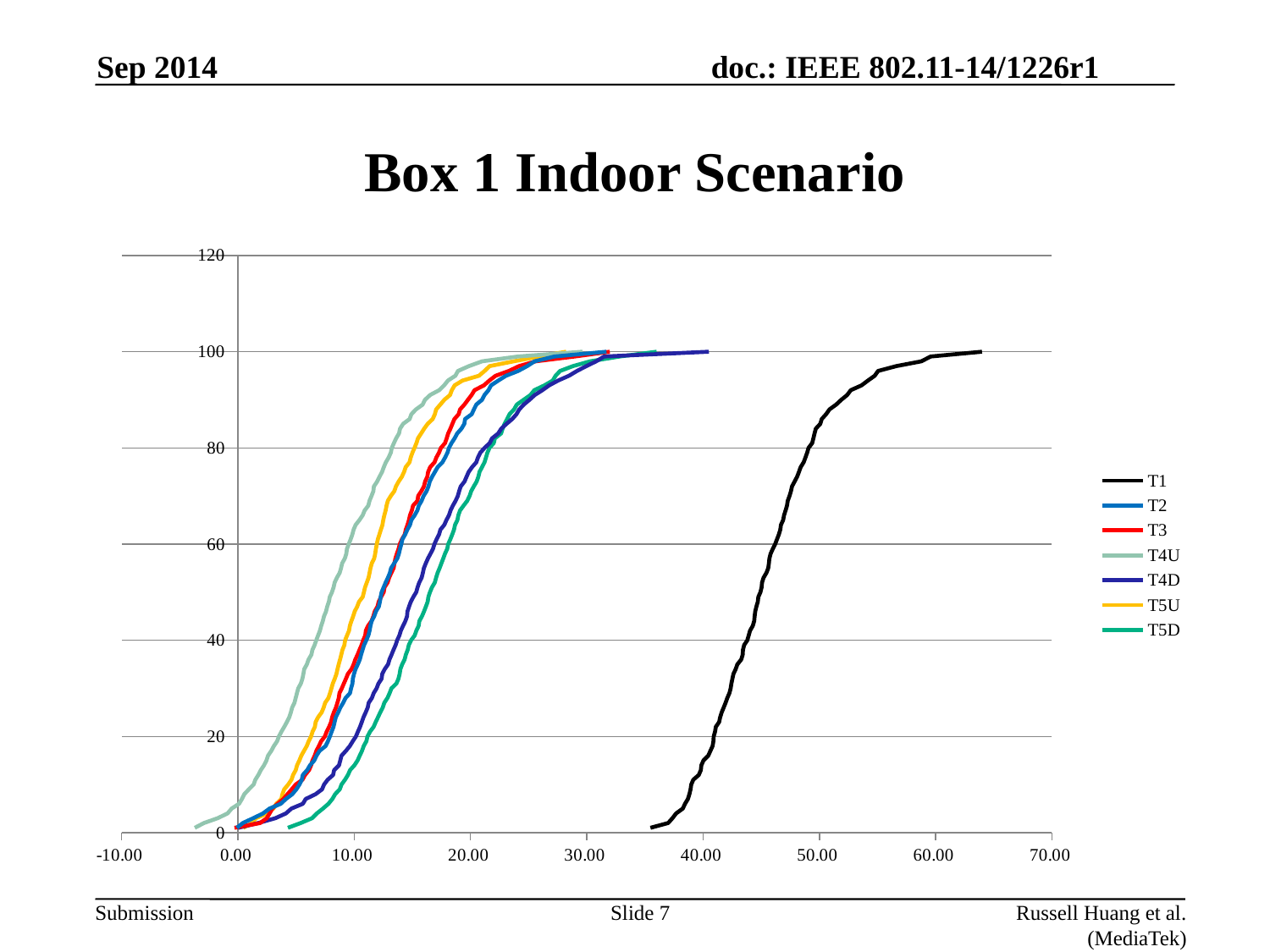
How many series does the legend list? 7 Do the values of each series rise or fall as x increases? rise Which series lies furthest to the right on the x axis? T1 Which series is drawn in black in the legend? T1 Is the value of T1 at x = 55.00 greater or less than 80? greater Is the value of T4U at x = 5.00 greater or less than 20? greater What is the title of the chart? Box 1 Indoor Scenario What kind of chart is shown on the slide? line chart Is the value of T5D at x = 20.00 greater or less than 60? greater Which series lies furthest to the left on the x axis? T4U At x = 10.00, which series has the larger value, T4U or T5D? T4U